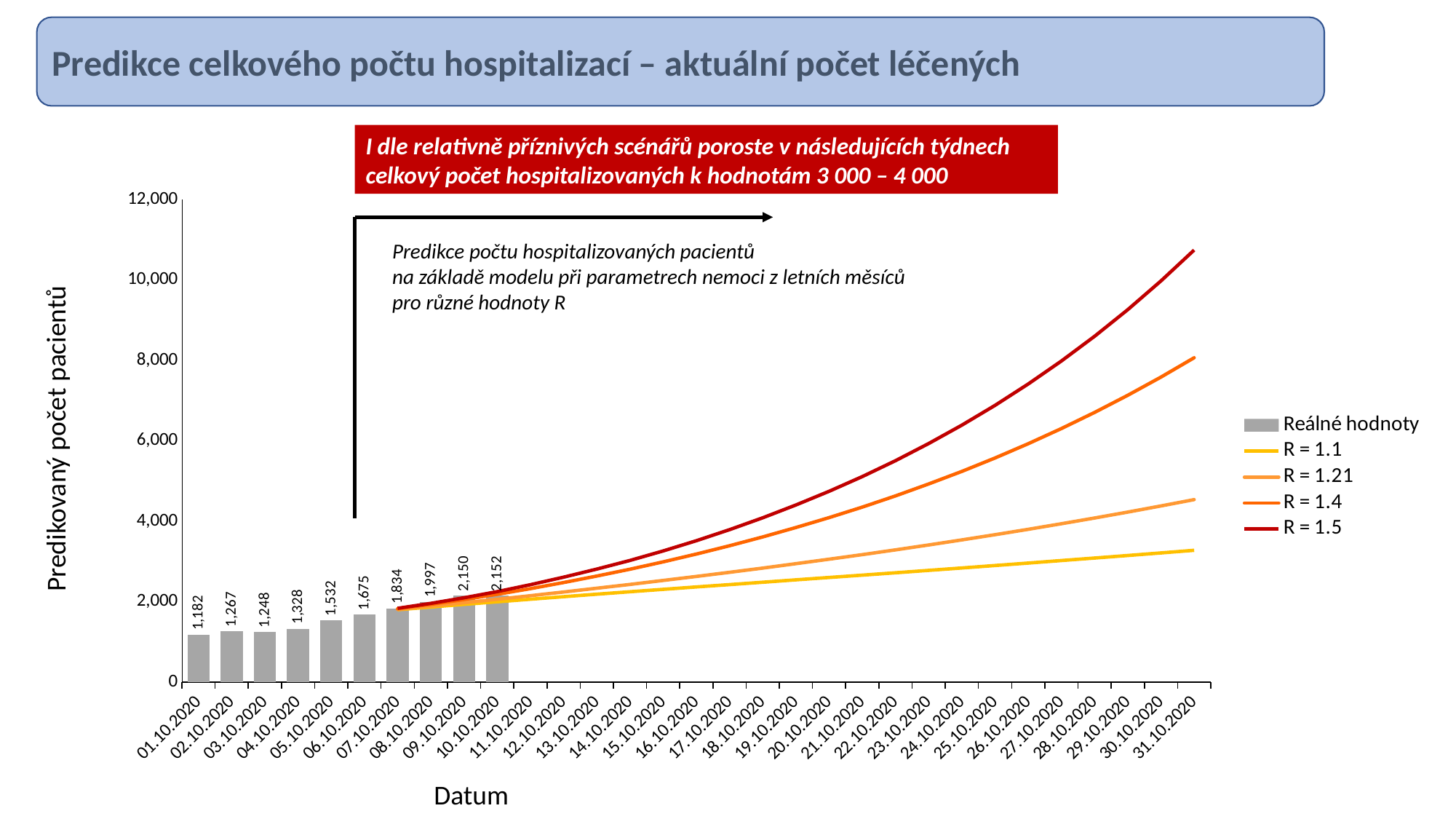
Is the value of the R = 1.1 line at 31.10.2020 greater or less than 4,000? less How many Reálné hodnoty bars are plotted on the chart? 10 What is the value of the Reálné hodnoty bar for 01.10.2020? 1,182 What is the difference between the Reálné hodnoty values for 02.10.2020 and 01.10.2020? 85 Do the R lines rise or fall from 10.10.2020 to 31.10.2020? Rise What is the value of the Reálné hodnoty bar for 10.10.2020? 2,152 Which date has the lowest Reálné hodnoty bar? 01.10.2020 How many series does the legend list? 5 Is the value of the R = 1.5 line at 31.10.2020 greater or less than 10,000? greater Which is larger, the Reálné hodnoty value for 03.10.2020 or for 04.10.2020? 04.10.2020 What is the value of the Reálné hodnoty bar for 05.10.2020? 1,532 What kind of chart is shown on the slide? Combined bar and line chart